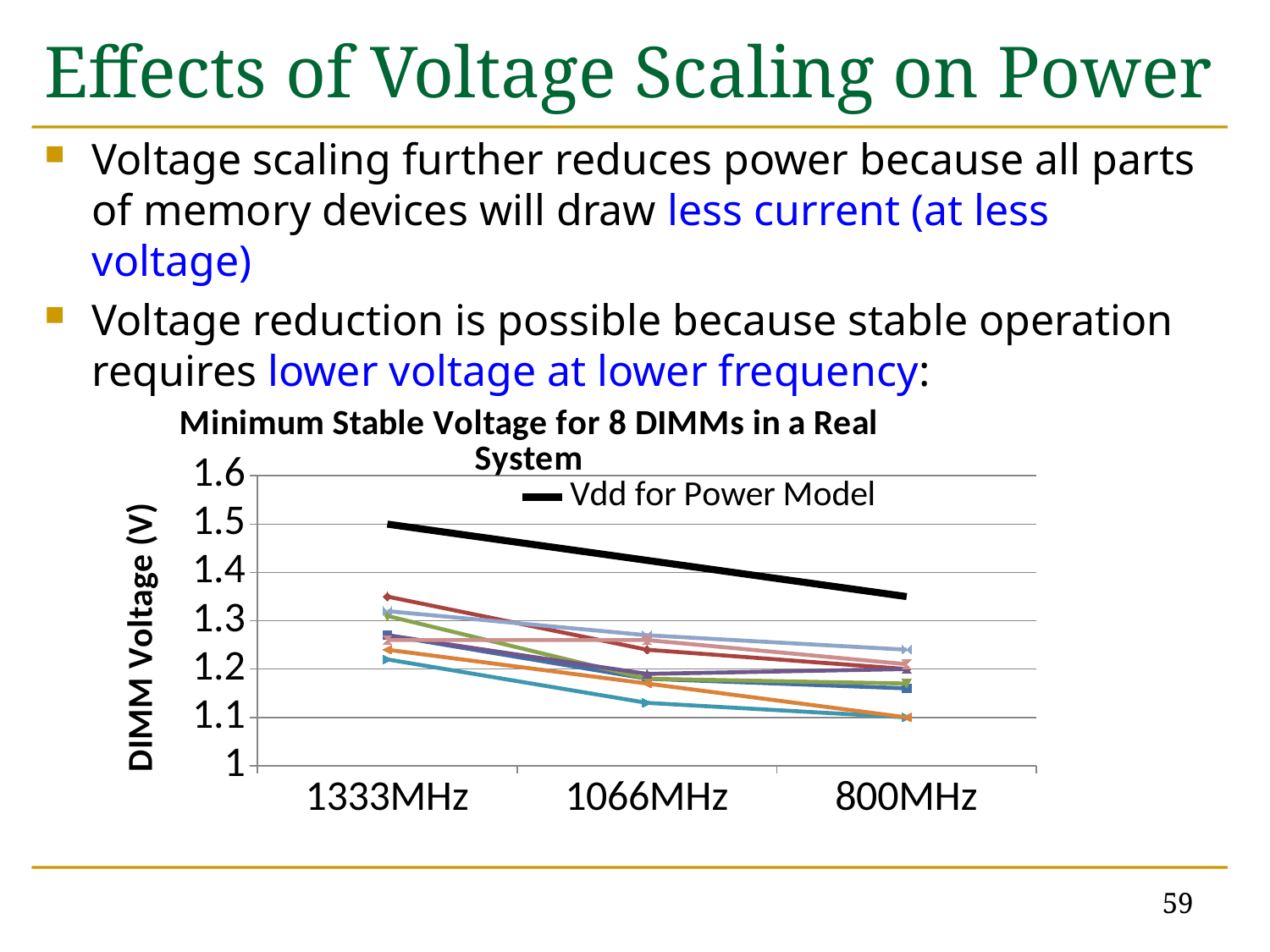
Is the value of Vdd for Power Model at 800MHz greater or less than 1.4? less Does the Vdd for Power Model line rise or fall from 1333MHz to 800MHz? fall Is the value of Vdd for Power Model at 1066MHz greater or less than 1.5? less What is the title of the chart? Minimum Stable Voltage for 8 DIMMs in a Real System How many series does the legend list? 1 How many frequency categories are shown on the x axis? 3 What is the value of Vdd for Power Model at 1333MHz? 1.5 At which frequency is Vdd for Power Model highest? 1333MHz What kind of chart is shown on the slide? line chart What is the label of the vertical axis? DIMM Voltage (V) At 800MHz, which is larger: Vdd for Power Model or the minimum stable voltage of any of the DIMM lines? Vdd for Power Model Is the value of Vdd for Power Model at 800MHz greater or less than 1.3? greater